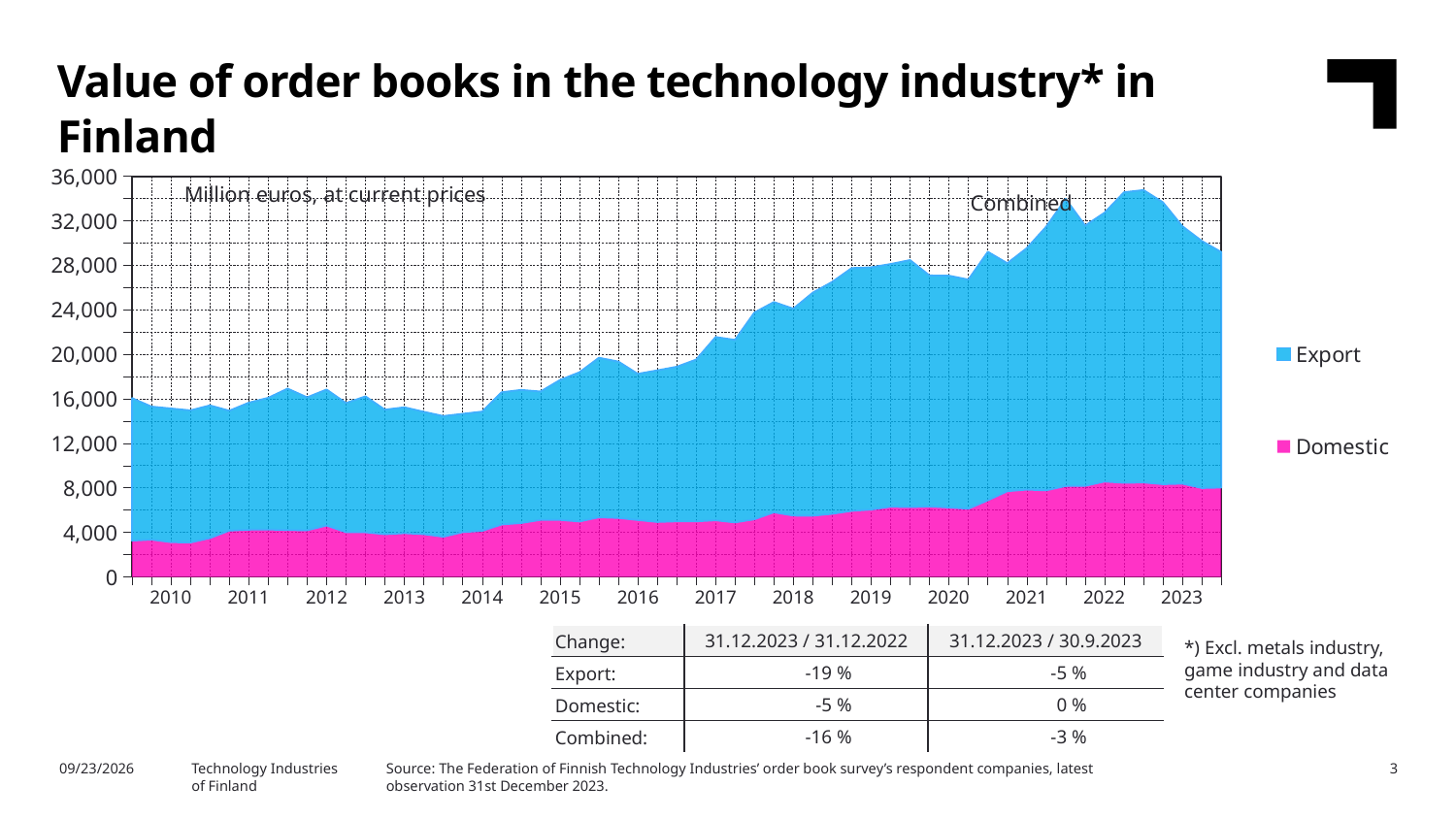
Does the Domestic value of order books generally rise or fall from 2010 to 2023? rise Which two series are listed in the chart legend? Export and Domestic Which series is larger throughout the chart, Export or Domestic? Export Is the Domestic value of order books at the start of 2010 greater or less than 4,000? less Is the combined value of order books at its 2022 peak greater or less than 32,000? greater What kind of chart is shown on the slide? Stacked area chart Is the combined value of order books at the end of 2023 greater or less than 32,000? less In which year does the combined value of order books reach its highest point? 2022 How many series does the chart legend list? 2 How many years are labelled on the x axis of the chart? 14 What unit is the chart measured in, according to the label inside the plot area? Million euros, at current prices